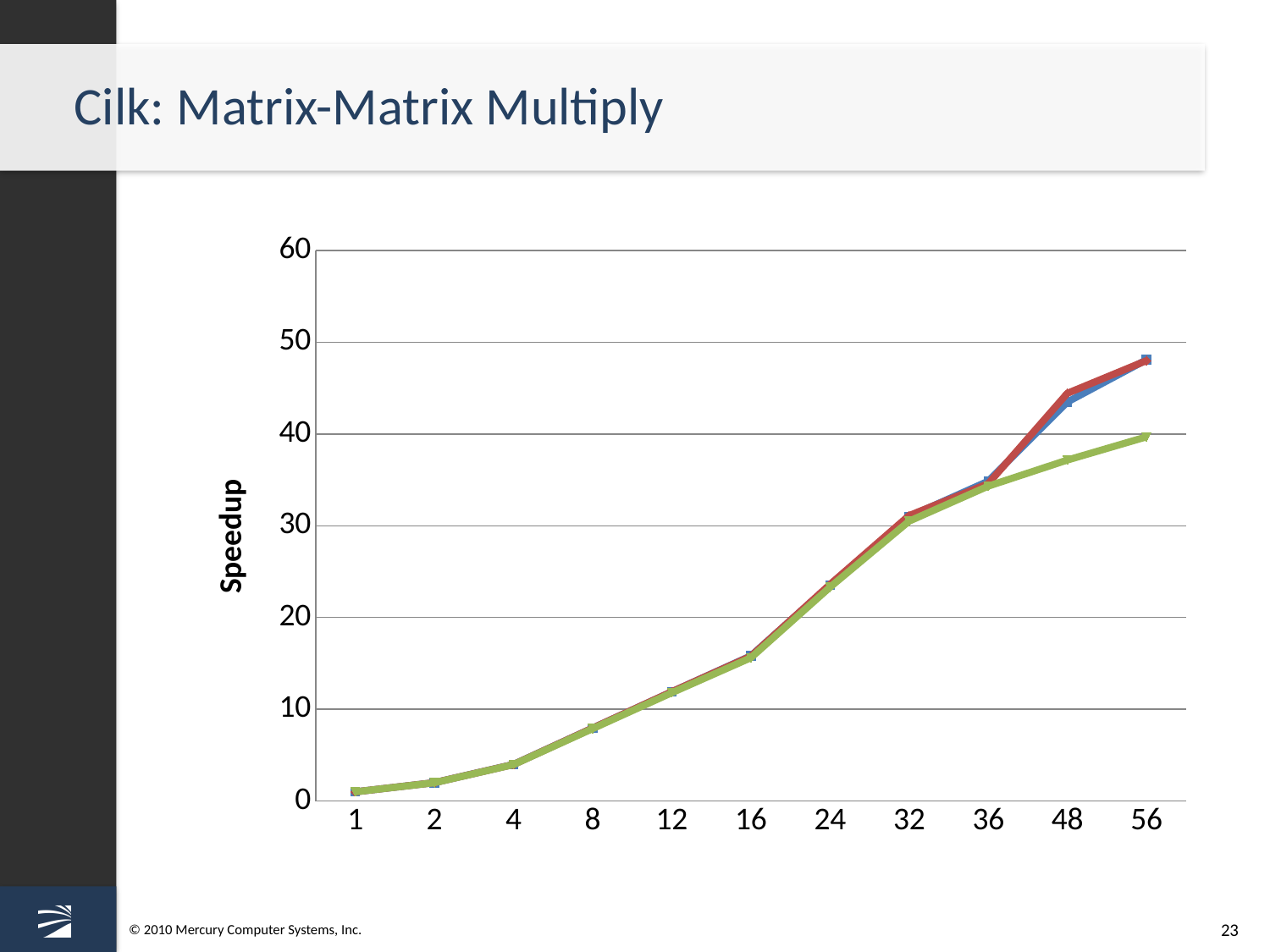
Is the speedup value of the red line at x = 56 greater or less than 40? greater At x = 56, which line shows the higher speedup, the green line or the red line? the red line Is the speedup value of the green line at x = 48 greater or less than 40? less Do the plotted speedup values rise or fall as the x-axis values increase from 1 to 56? rise Is the speedup value at x = 8 greater or less than 10? less What kind of chart is shown on the slide? line chart What is the highest tick value shown on the vertical axis? 60 At which x-axis value does the green line reach its highest speedup? 56 What is the label on the vertical axis of the chart? Speedup How many points are marked along the x axis of the chart? 11